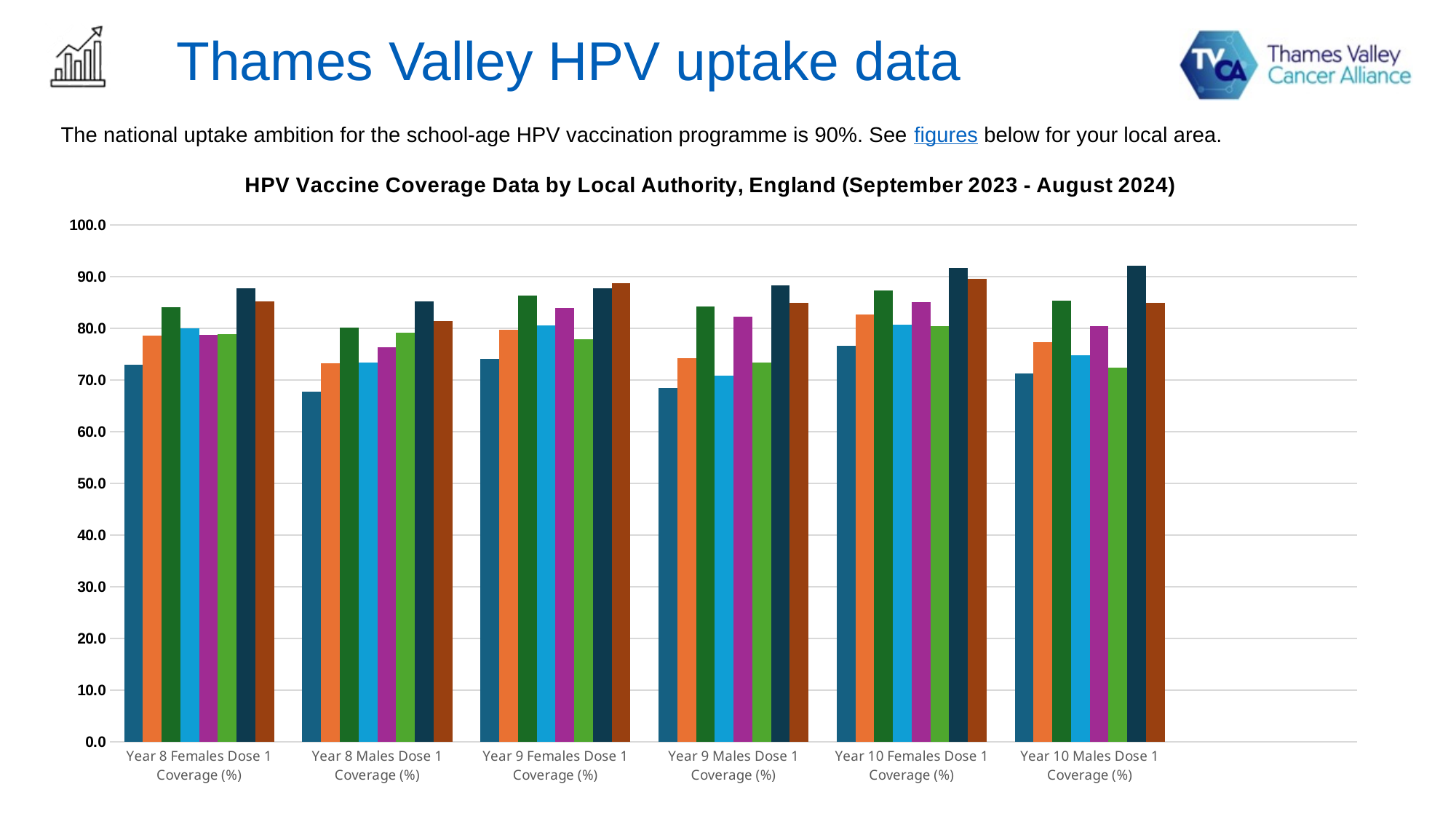
Is the shortest bar for Year 9 Males Dose 1 Coverage (%) greater or less than 70? less How many categories are shown along the x axis of the chart? 6 What is the highest value shown on the y axis of the chart? 100.0 How many bars are plotted for each category on the x axis? 8 What is the title of the chart? HPV Vaccine Coverage Data by Local Authority, England (September 2023 - August 2024) Is the tallest bar for Year 10 Males Dose 1 Coverage (%) greater or less than 90? greater Is the shortest bar for Year 10 Females Dose 1 Coverage (%) greater or less than 70? greater What kind of chart is shown on the slide? Bar chart Which category has the taller shortest bar: Year 8 Females Dose 1 Coverage (%) or Year 8 Males Dose 1 Coverage (%)? Year 8 Females Dose 1 Coverage (%)